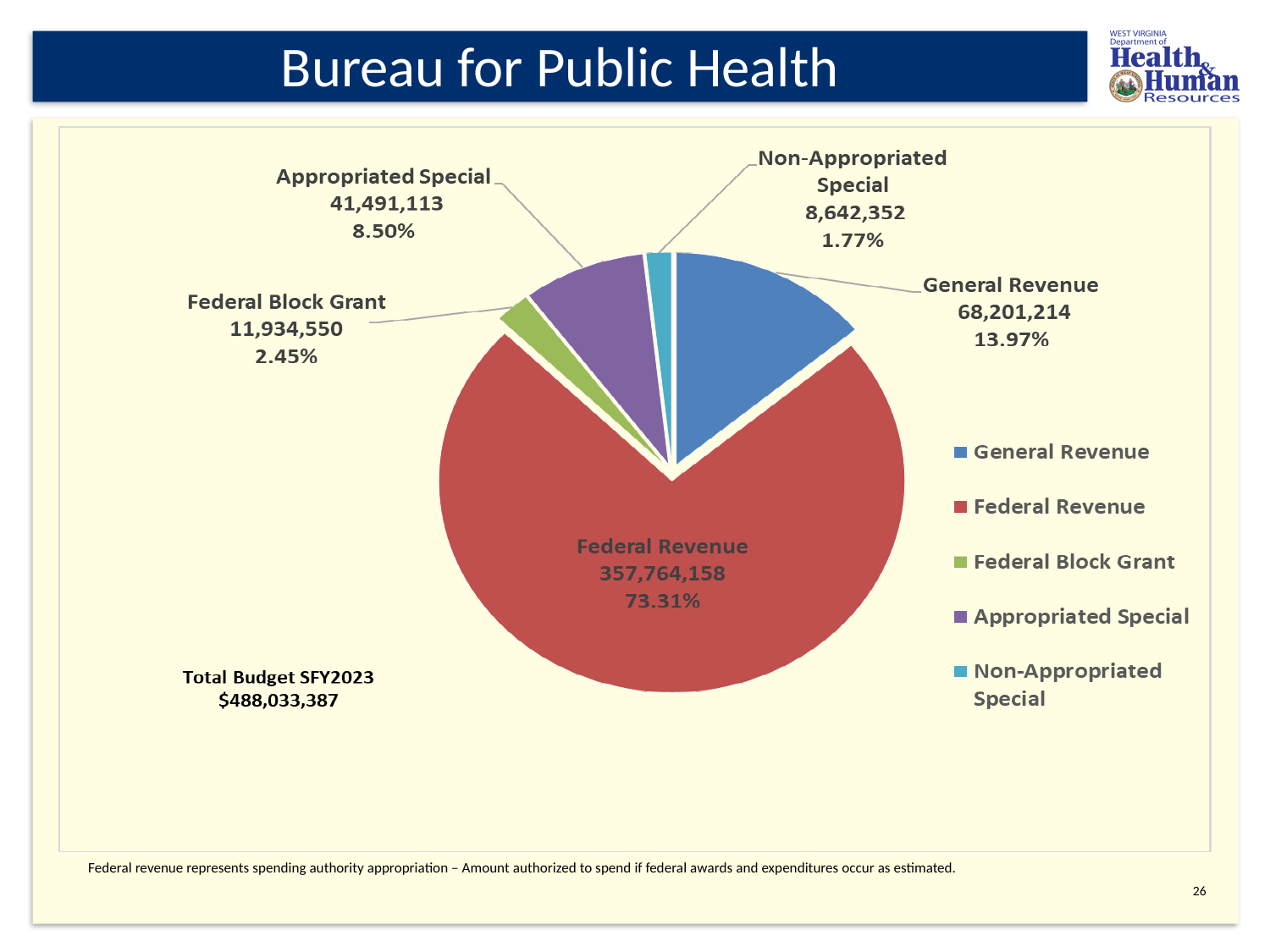
What is the value for Non-Appropriated Special? 8,642,352 What is the value for Appropriated Special? 41,491,113 Which is larger, Federal Block Grant or Non-Appropriated Special? Federal Block Grant How many categories does the legend list? 5 What is the value for Federal Revenue? 357,764,158 What share of the pie does Federal Block Grant represent? 2.45% What share of the pie does Federal Revenue represent? 73.31% Which category has the smallest slice? Non-Appropriated Special What is the value for General Revenue? 68,201,214 What is the difference between General Revenue and Appropriated Special? 26,710,101 Which category has the largest slice? Federal Revenue What type of chart is shown on the slide? Pie chart